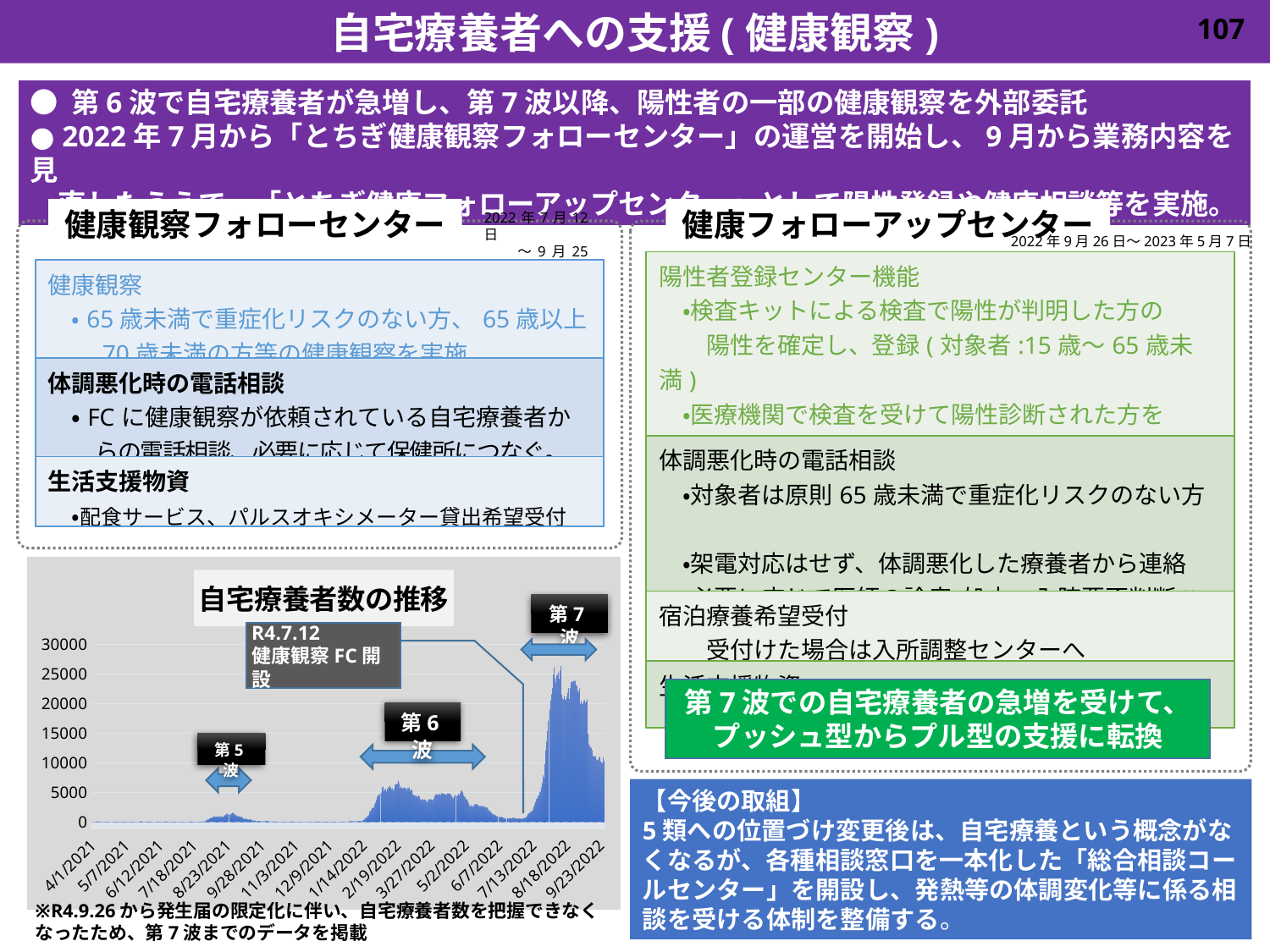
「自宅療養者数の推移」のグラフで、第5波のピーク時の自宅療養者数は5000より多いですか、少ないですか？ 少ない 「自宅療養者数の推移」のグラフで、第7波のピーク時の自宅療養者数は25000より多いですか、少ないですか？ 多い 「自宅療養者数の推移」のグラフで、第5波・第6波・第7波のうち自宅療養者数のピークが最も低いのはどれですか？ 第5波 「自宅療養者数の推移」のグラフで、第5波・第6波・第7波のうち自宅療養者数のピークが最も高いのはどれですか？ 第7波 「自宅療養者数の推移」のグラフで、横軸の最初の日付ラベルは何ですか？ 4/1/2021 「自宅療養者数の推移」のグラフのタイトルは何ですか？ 自宅療養者数の推移 「自宅療養者数の推移」のグラフで、縦軸の最大目盛りはいくつですか？ 30000 「自宅療養者数の推移」のグラフで、横軸の最後の日付ラベルは何ですか？ 9/23/2022 「自宅療養者数の推移」のグラフで、第6波のピーク時の自宅療養者数は10000より多いですか、少ないですか？ 少ない 「自宅療養者数の推移」のグラフで、横軸に表示されている日付ラベルはいくつありますか？ 16 「自宅療養者数の推移」のグラフはどの種類のグラフですか？ 面グラフ 「自宅療養者数の推移」のグラフで、第6波と第7波ではどちらのピークの自宅療養者数が多いですか？ 第7波